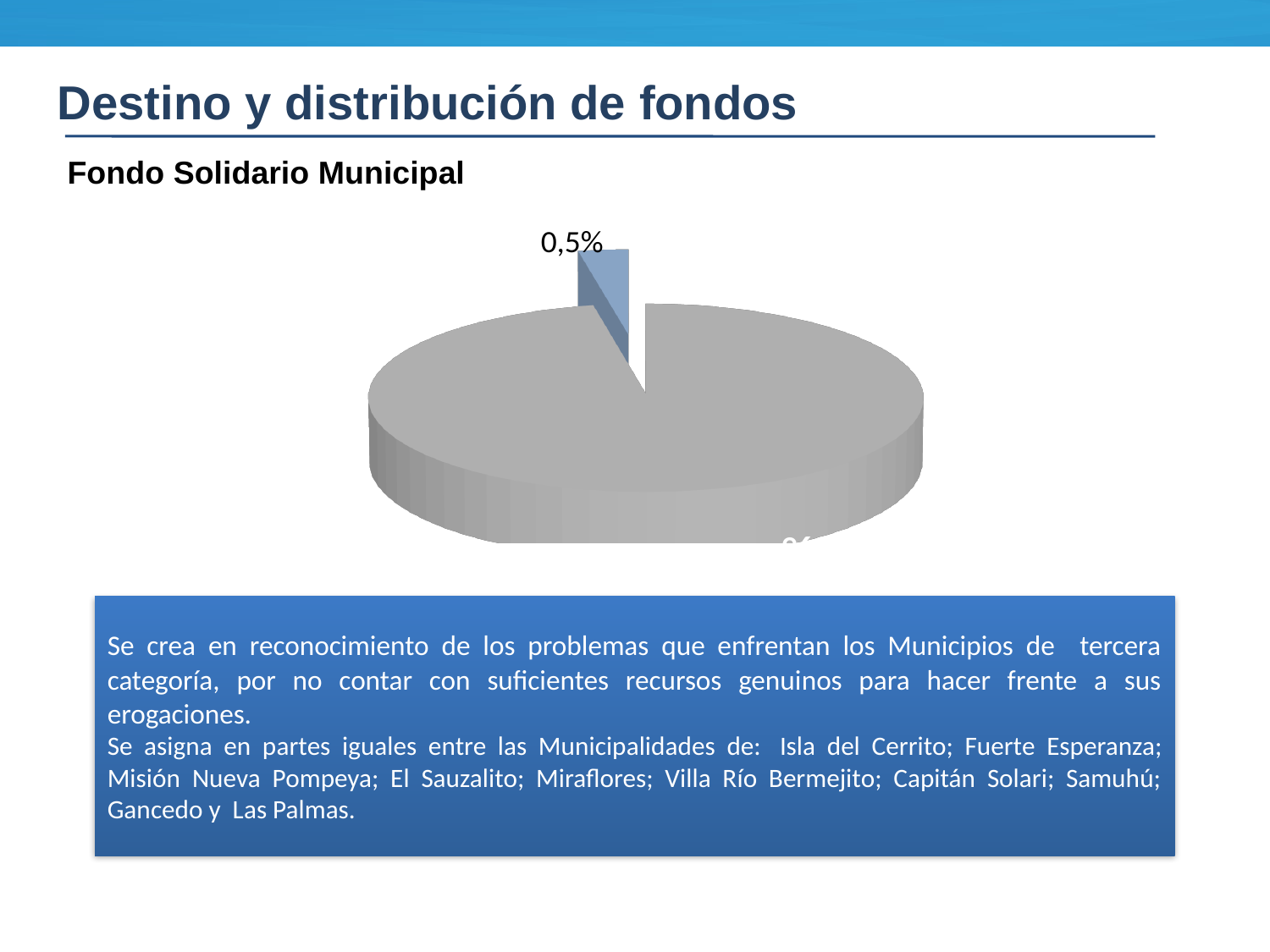
What percentage is printed on the small blue slice of the pie chart? 0,5% Which slice of the pie chart is larger, the blue slice or the gray slice? the gray slice What colour is the slice labelled 0,5%? blue How many slices does the pie chart have? 2 Which slice of the pie chart is the smallest? the blue slice (0,5%) Which slice of the pie chart is the largest? the gray slice What kind of chart is shown on the slide? pie chart What heading appears directly above the pie chart? Fondo Solidario Municipal